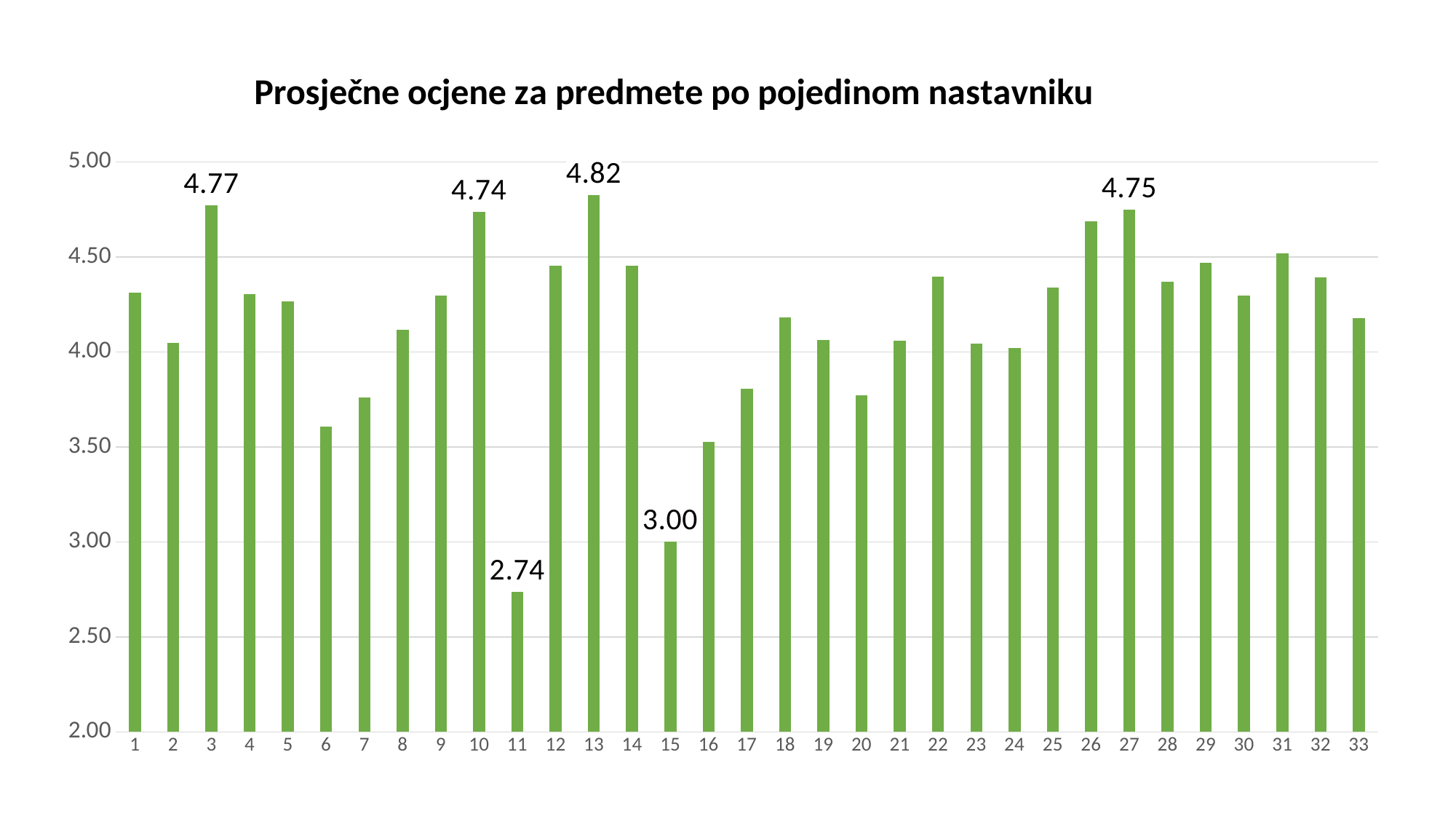
What is the value for teacher 3? 4.77 What is the value for teacher 15? 3.00 Is the value for teacher 6 greater or less than 4.00? less Is the value for teacher 26 greater or less than 4.50? greater Which teacher has the highest average grade? 13 What type of chart is shown on the slide? bar chart How many categories (teachers) are shown on the x axis? 33 Which teacher has the lowest average grade? 11 Which is larger, the value for teacher 3 or the value for teacher 27? teacher 3 What is the difference between the values for teacher 13 and teacher 11? 2.08 What is the title of the chart? Prosječne ocjene za predmete po pojedinom nastavniku What is the value for teacher 11? 2.74